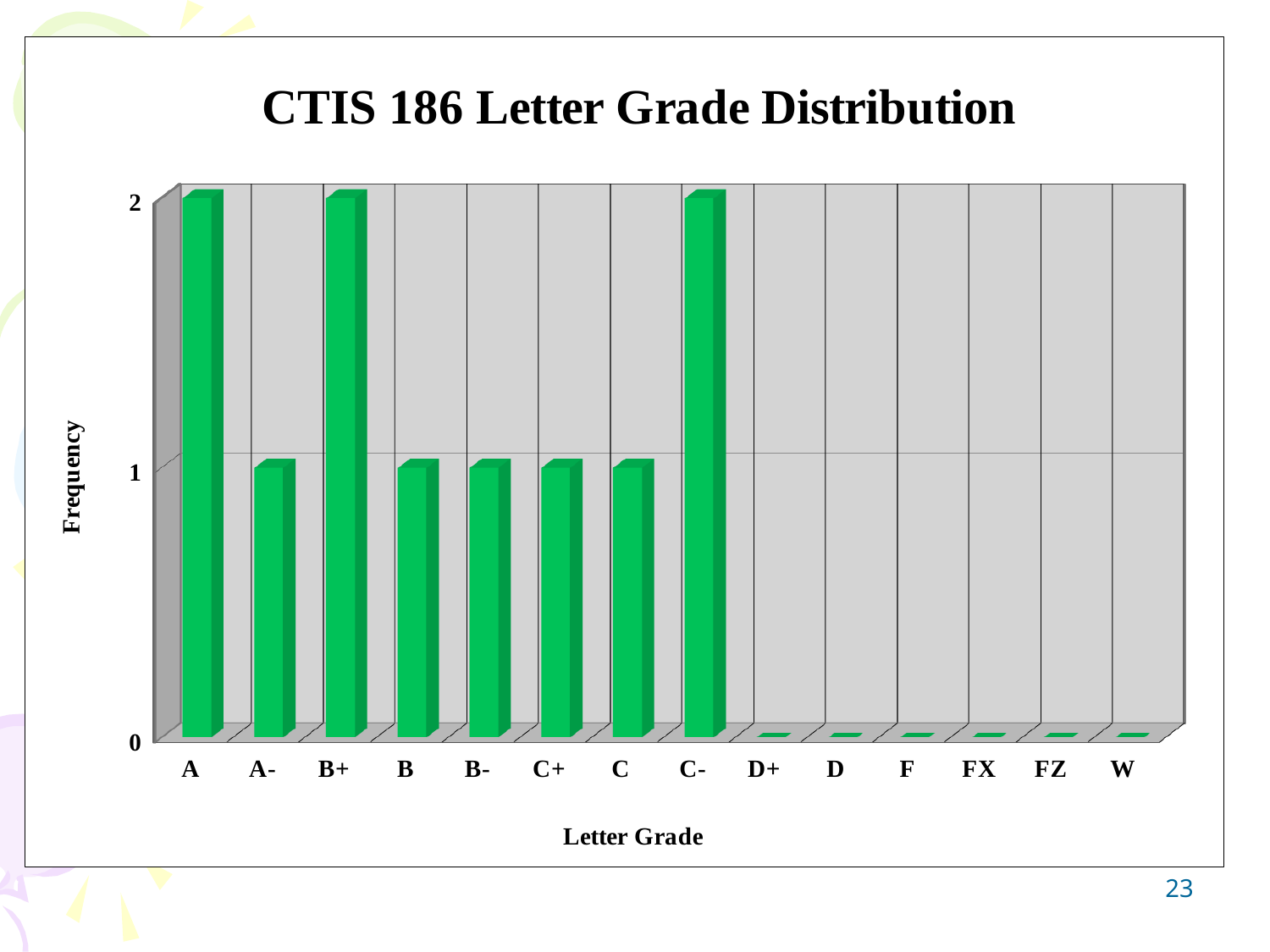
How many letter grade categories are shown on the x axis? 14 What is the frequency for letter grade C-? 2 What is the frequency for letter grade D? 0 What is the difference between the frequency for A and the frequency for A-? 1 Which has a higher frequency, B+ or B-? B+ What is the label of the vertical axis? Frequency What kind of chart is shown on the slide? Bar chart What is the frequency for letter grade A? 2 Which has a higher frequency, C or C-? C- Which letter grades have the highest frequency? A, B+, C- What is the title of the chart? CTIS 186 Letter Grade Distribution What is the frequency for letter grade B? 1